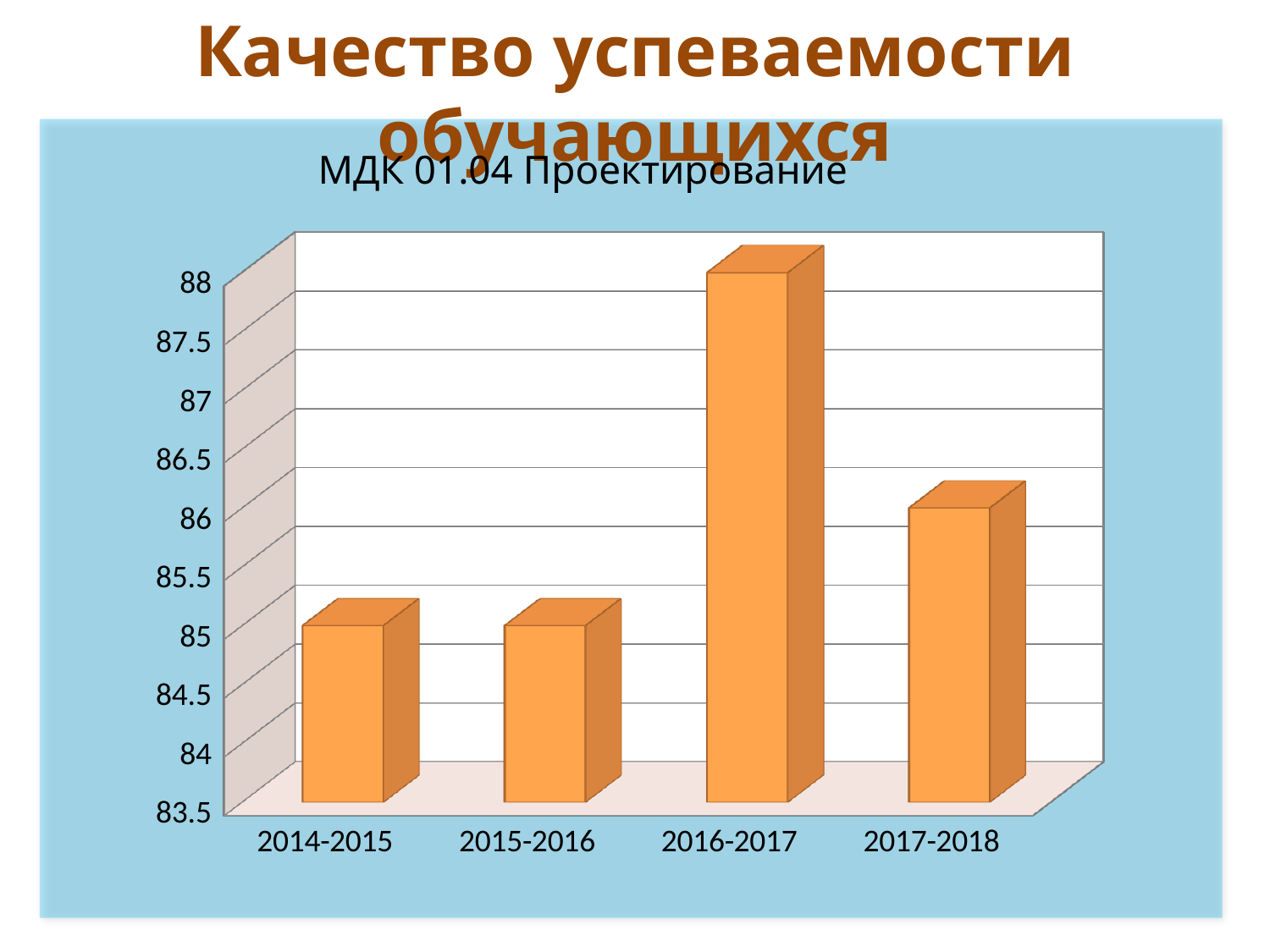
What is the title of the chart? МДК 01.04 Проектирование What is the lowest value shown on the vertical axis of the chart? 83.5 What type of chart is shown on the slide? bar chart What is the value for 2017-2018? 86 What is the value for 2014-2015? 85 Does the value rise or fall from 2015-2016 to 2016-2017? rise Which is larger, the value for 2016-2017 or the value for 2017-2018? 2016-2017 How many academic years are shown on the x axis of the chart? 4 Which academic year has the highest value in the chart? 2016-2017 Is the value for 2017-2018 greater or less than 85.5? greater Is the value for 2015-2016 greater or less than 86? less What is the value for 2016-2017? 88